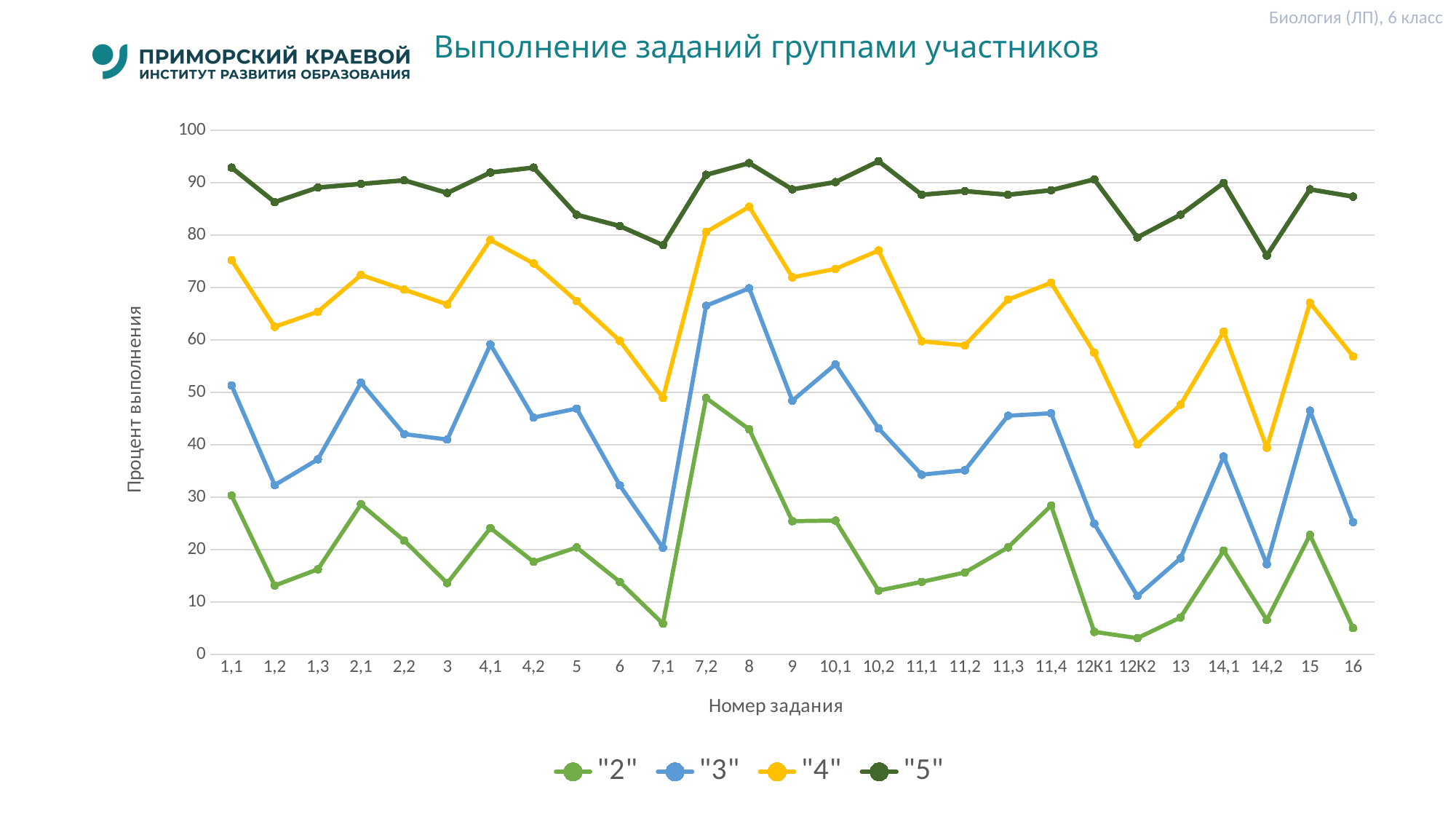
For which task number does the "2" series reach its highest value? 7,2 Is the value for the "2" series at task 7,1 greater or less than 10? less How many series does the legend list? 4 How many task numbers (categories) are plotted along the x axis? 27 What kind of chart is shown on the slide? line chart Is the value for the "5" series at task 14,2 greater or less than 80? less For which task number does the "3" series reach its lowest value? 12К2 Is the value for the "4" series at task 8 greater or less than 80? greater What is the label of the y axis? Процент выполнения Does the "5" series rise or fall from task 1,1 to task 1,2? fall Which is larger for the "4" series: the value at task 1,1 or at task 1,2? 1,1 For which task number does the "3" series reach its highest value? 8